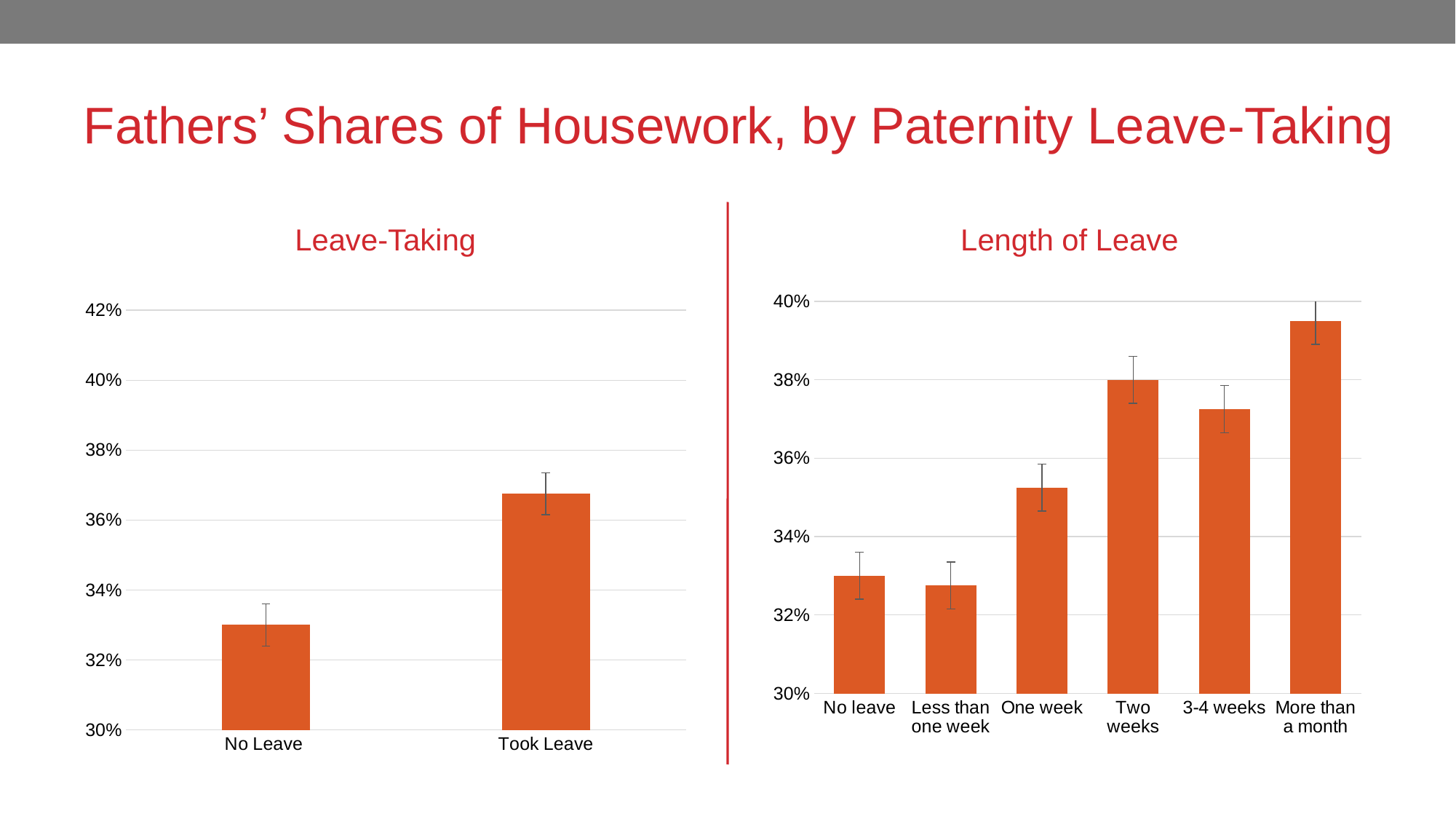
In the Leave-Taking chart, which category has the higher value, No Leave or Took Leave? Took Leave In the Length of Leave chart, which is larger, the value for Two weeks or the value for 3-4 weeks? Two weeks In the Length of Leave chart, which category has the highest value? More than a month In the Leave-Taking chart, is the value for No Leave greater or less than 34%? less What kind of chart is the Leave-Taking chart on the left? bar chart How many categories are shown in the Leave-Taking chart? 2 In the Length of Leave chart, is the value for Less than one week greater or less than 34%? less What is the title of the chart on the right side of the slide? Length of Leave In the Length of Leave chart, is the value for More than a month greater or less than 38%? greater How many categories are shown in the Length of Leave chart? 6